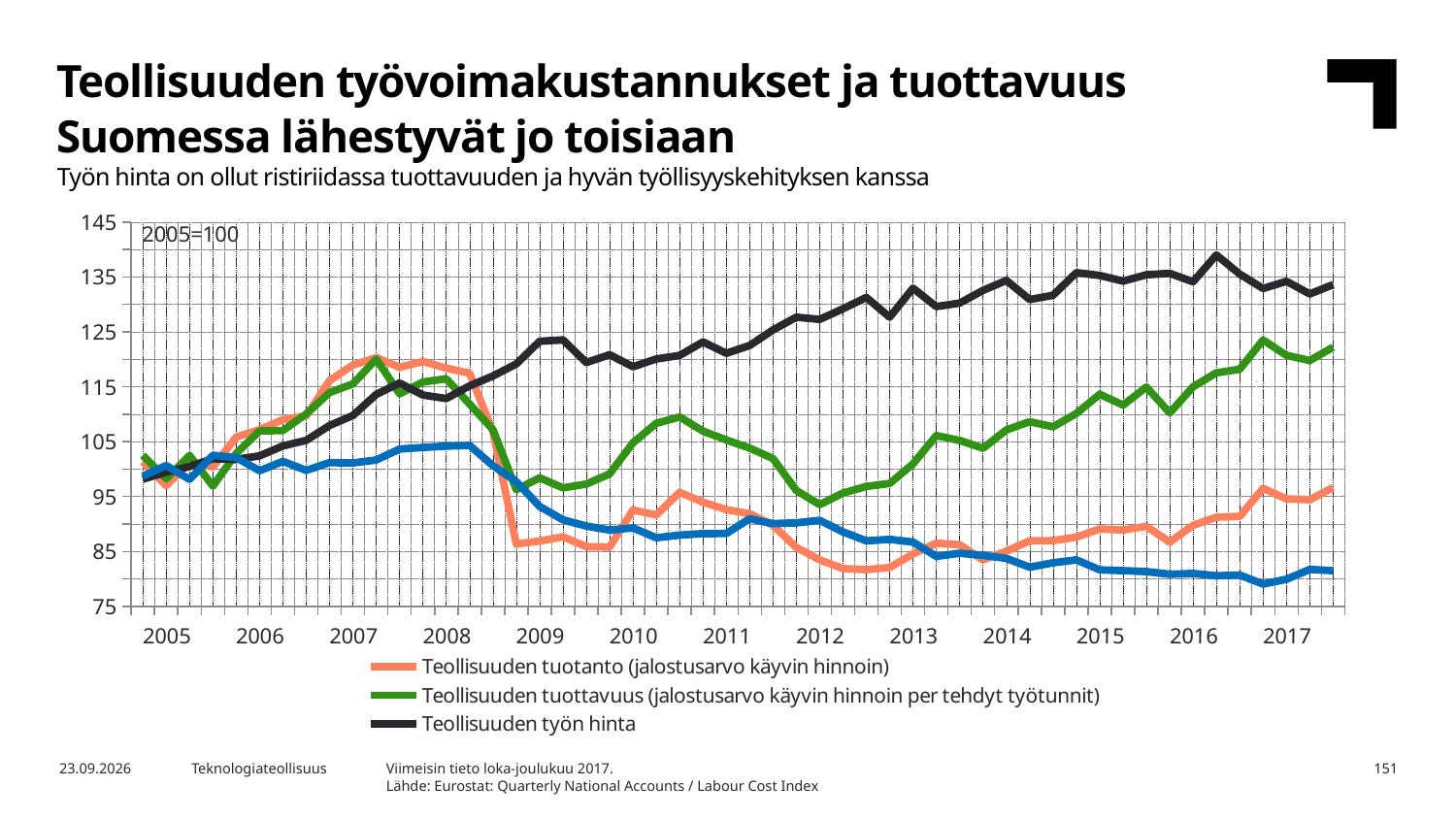
Is the value for Teollisuuden tuottavuus in 2012 greater or less than 105? less In 2017, which is higher: Teollisuuden työn hinta or Teollisuuden tuotanto? Teollisuuden työn hinta Does the Teollisuuden tuotanto line rise or fall from 2008 to 2009? fall Is the value for Teollisuuden työn hinta in 2017 greater or less than 125? greater How many series does the chart legend list? 3 Is the value for Teollisuuden työn hinta at the start of 2005 greater or less than 105? less Does the Teollisuuden työn hinta line rise or fall overall from 2005 to 2017? rise What kind of chart is shown on the slide? line chart What base year and index value is noted at the top of the chart? 2005=100 Which of the legend series has the highest value in 2017? Teollisuuden työn hinta